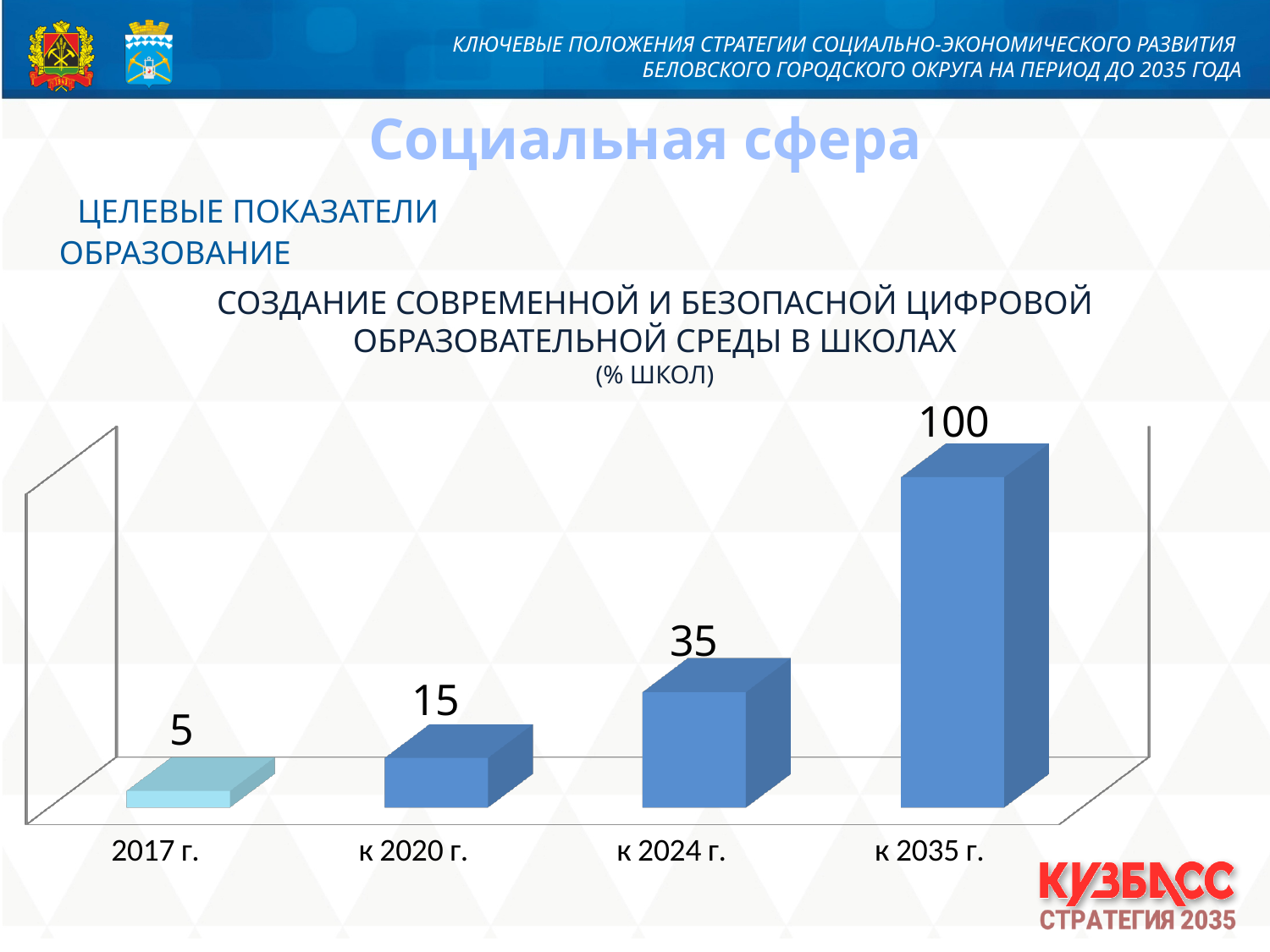
What is the value for к 2020 г.? 15 What is the value for к 2035 г.? 100 What is the value for к 2024 г.? 35 How many categories are shown on the x axis? 4 What is the difference between the values for к 2035 г. and к 2024 г.? 65 What is the difference between the values for к 2020 г. and 2017 г.? 10 What kind of chart is shown on the slide? bar chart Which is larger, the value for к 2024 г. or the value for к 2020 г.? к 2024 г. Which category has the highest value? к 2035 г. Do the values rise or fall from 2017 г. to к 2035 г.? rise What is the value for 2017 г.? 5 Which category has the lowest value? 2017 г.